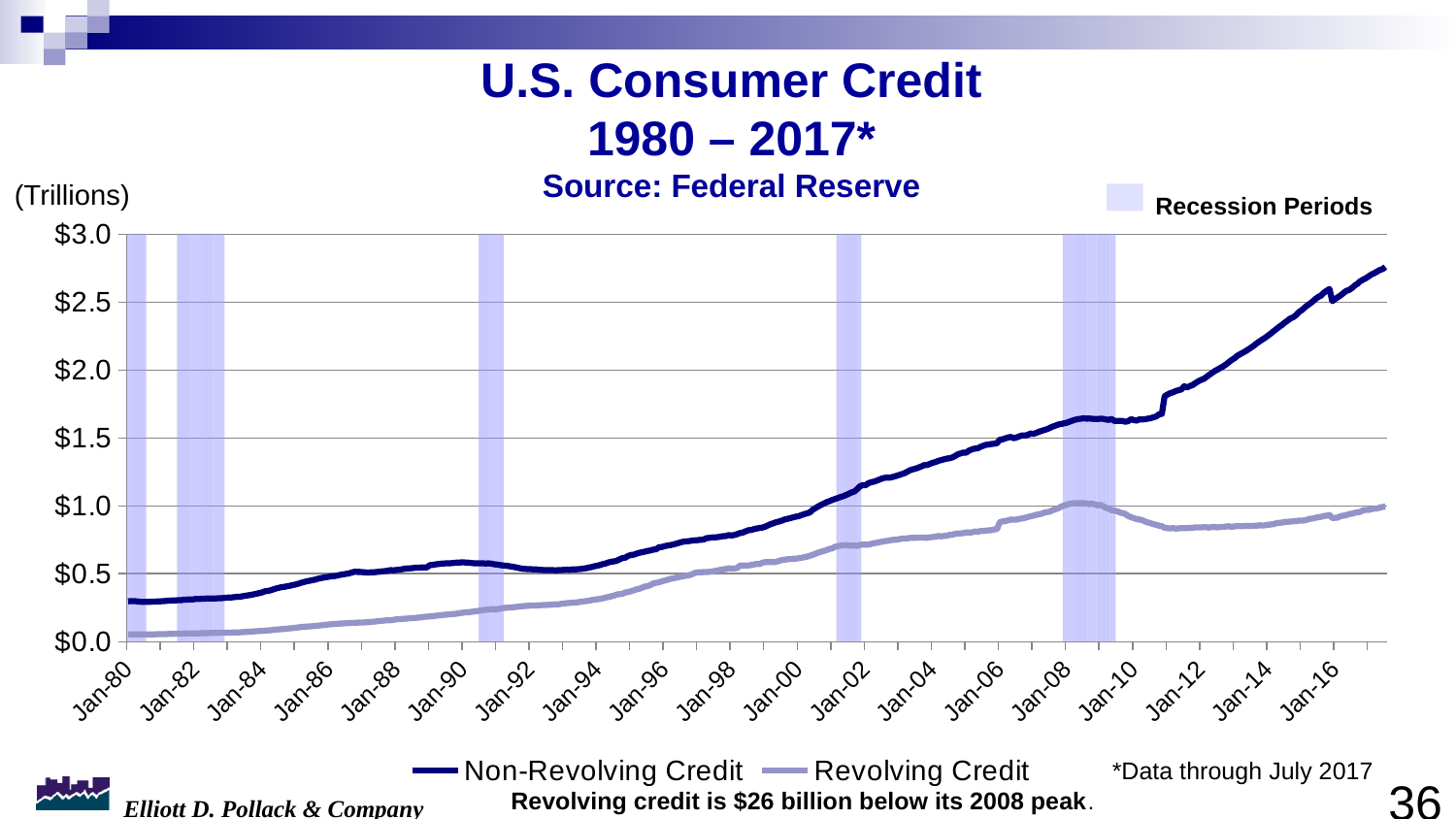
What kind of chart is shown on the slide? line chart What are the two series named in the legend? Non-Revolving Credit and Revolving Credit Does Non-Revolving Credit generally rise or fall from Jan-80 to Jan-16? rise Does Revolving Credit rise or fall between Jan-08 and Jan-10? fall Which series has the higher value at Jan-10, Non-Revolving Credit or Revolving Credit? Non-Revolving Credit Is the value for Non-Revolving Credit at Jan-14 greater or less than $2.5? less Is the value for Non-Revolving Credit at Jan-08 greater or less than $1.5? greater What does the light blue shading on the chart represent? Recession Periods Which series has the higher value at Jan-16, Non-Revolving Credit or Revolving Credit? Non-Revolving Credit Is the value for Non-Revolving Credit at Jan-02 greater or less than $1.0? greater How many series does the legend list? 2